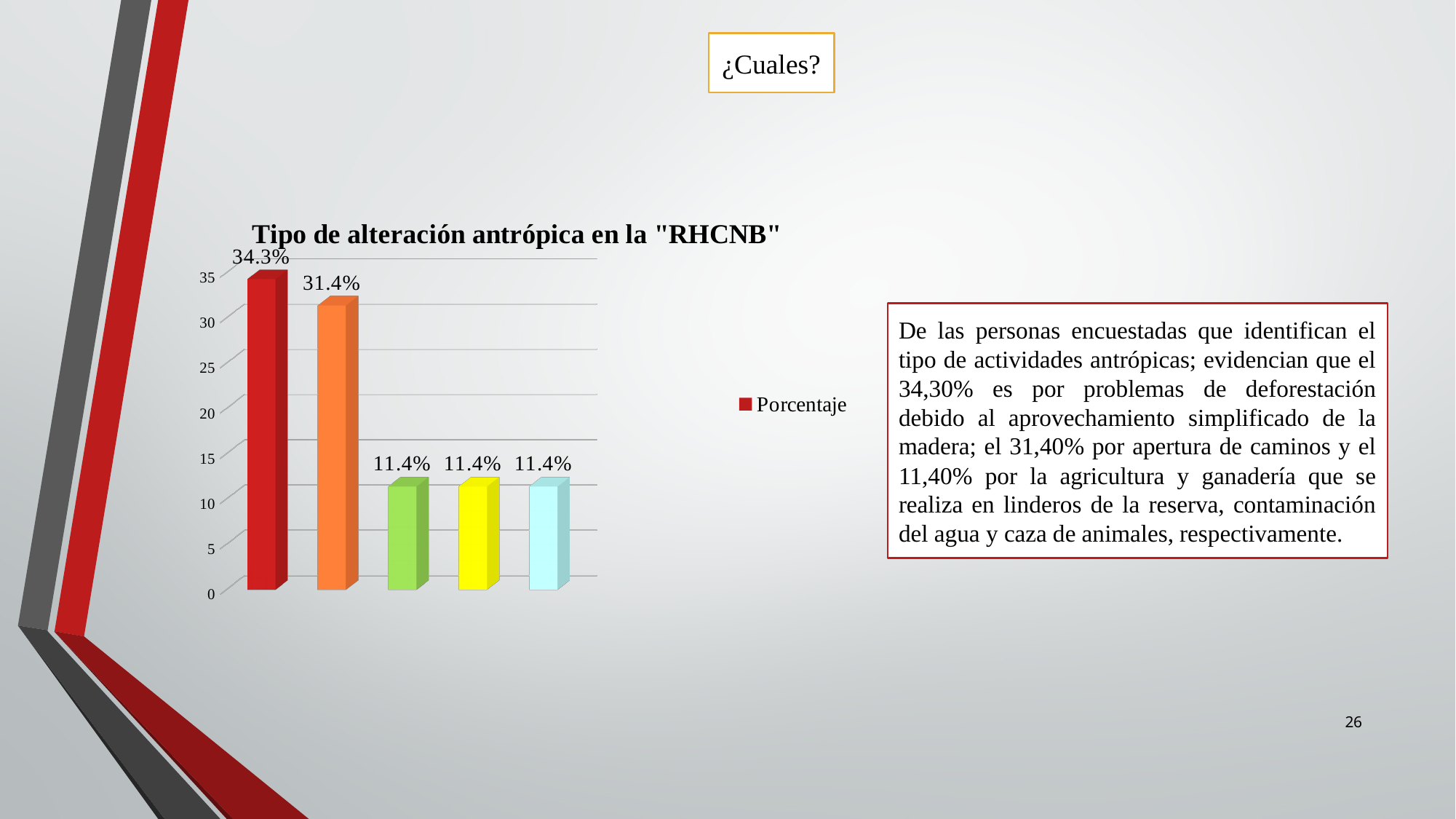
Which is larger, the second (orange) bar or the fourth (yellow) bar? the second (orange) bar How many series does the chart legend list? 1 What is the difference between the first (red) bar and the second (orange) bar? 2.9% What is the title of the chart? Tipo de alteración antrópica en la "RHCNB" What type of chart is shown on the slide? bar chart Which bar has the highest value? the first (red) bar, 34.3% What is the value shown on the third (green) bar? 11.4% What is the value shown on the first (red) bar? 34.3% Do the values rise or fall from left to right across the bars? fall How many bars are plotted in the chart? 5 What is the value shown on the second (orange) bar? 31.4% What is the name of the series shown in the legend? Porcentaje